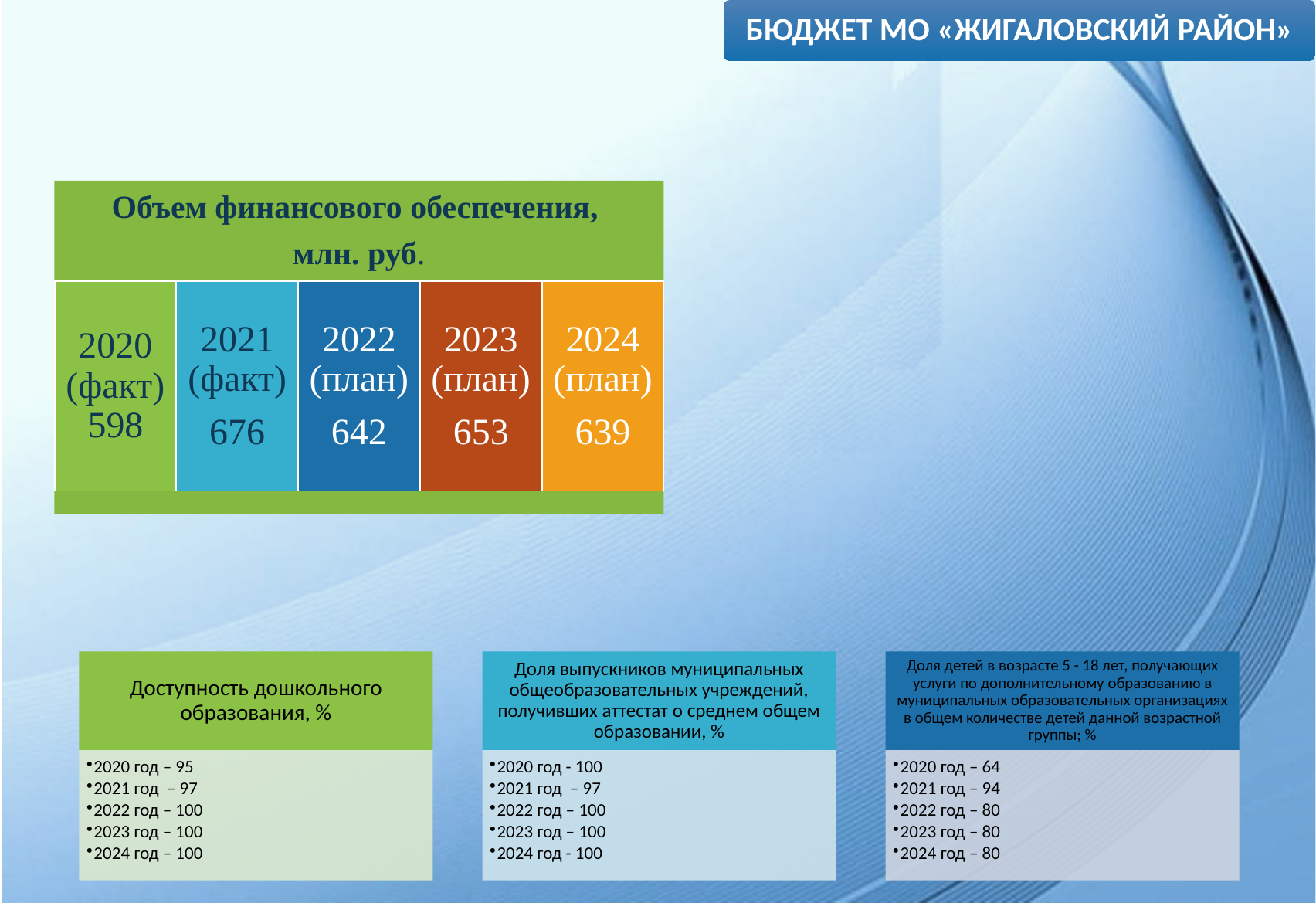
In the 'Объем финансового обеспечения, млн. руб.' block, what is the value for 2024 (план)? 639 What unit is given in the title of the 'Объем финансового обеспечения' block? млн. руб. How many years are shown in the 'Объем финансового обеспечения, млн. руб.' block? 5 In the 'Объем финансового обеспечения, млн. руб.' block, how many years are marked as 'план'? 3 In the 'Объем финансового обеспечения, млн. руб.' block, which year has the lowest value? 2020 (факт) In the 'Объем финансового обеспечения, млн. руб.' block, which year has the highest value? 2021 (факт) In the 'Объем финансового обеспечения, млн. руб.' block, which is larger, the value for 2022 (план) or 2023 (план)? 2023 (план) In the 'Объем финансового обеспечения, млн. руб.' block, what is the value for 2021 (факт)? 676 In the 'Объем финансового обеспечения, млн. руб.' block, what is the value for 2020 (факт)? 598 In the 'Объем финансового обеспечения, млн. руб.' block, what is the value for 2022 (план)? 642 In the 'Объем финансового обеспечения, млн. руб.' block, what is the difference between the 2023 (план) and 2024 (план) values? 14 In the 'Объем финансового обеспечения, млн. руб.' block, what is the difference between the 2021 (факт) and 2020 (факт) values? 78